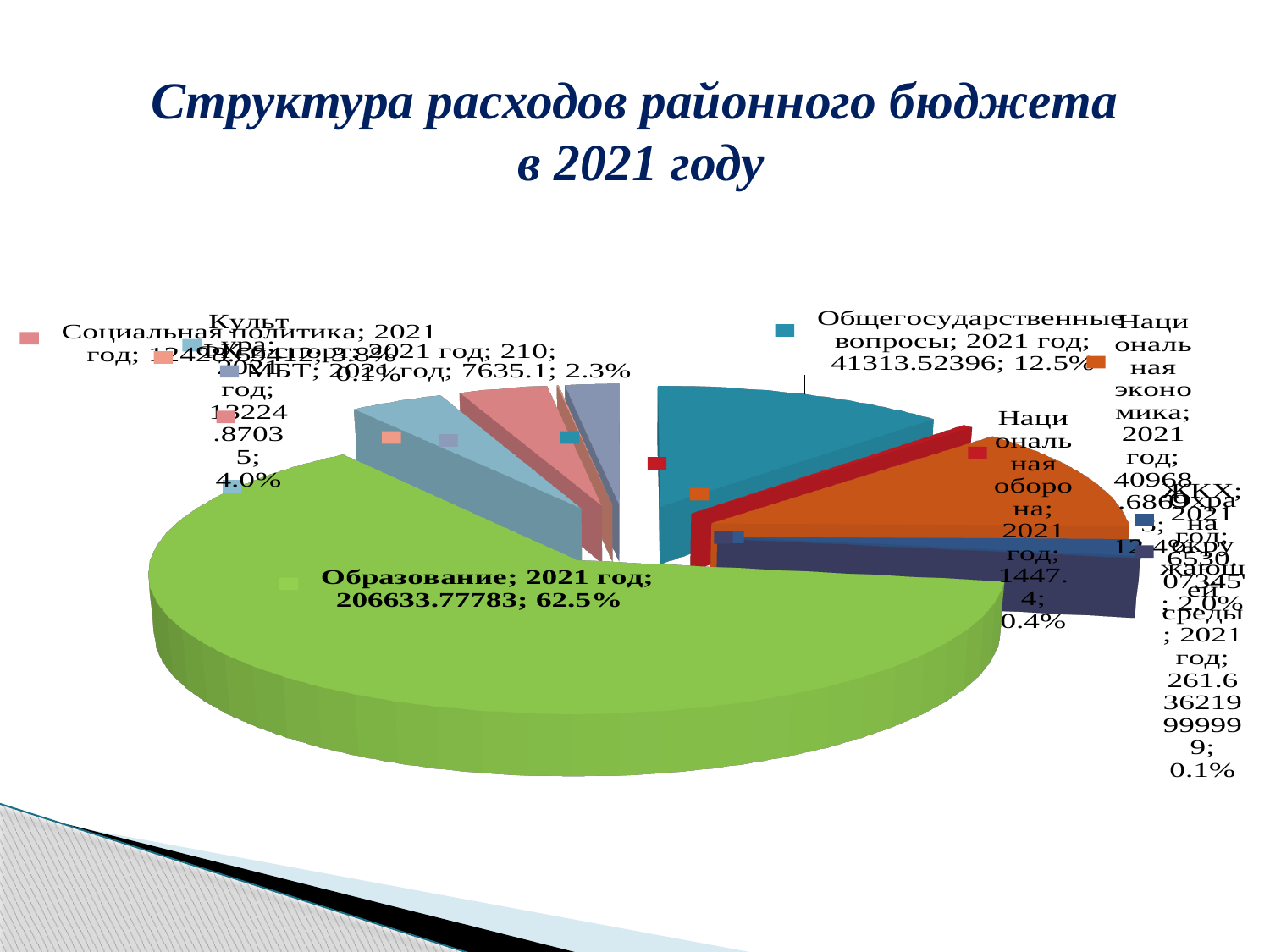
What is the value shown for Общегосударственные вопросы in 2021? 41313.52396 By how many percentage points does the share of Образование exceed the share of Общегосударственные вопросы? 50.0 percentage points What share of the pie does Общегосударственные вопросы take? 12.5% What is the title of the chart? Структура расходов районного бюджета в 2021 году What is the value shown for Образование in 2021? 206633.77783 Which slice is larger, Образование or Общегосударственные вопросы? Образование What share of the pie does Национальная оборона take? 0.4% What share of the pie does Образование take? 62.5% What is the value shown for Национальная оборона in 2021? 1447.4 Which category has the largest slice of the pie? Образование What kind of chart is shown on the slide? pie chart What is the value shown for МБТ in 2021? 7635.1